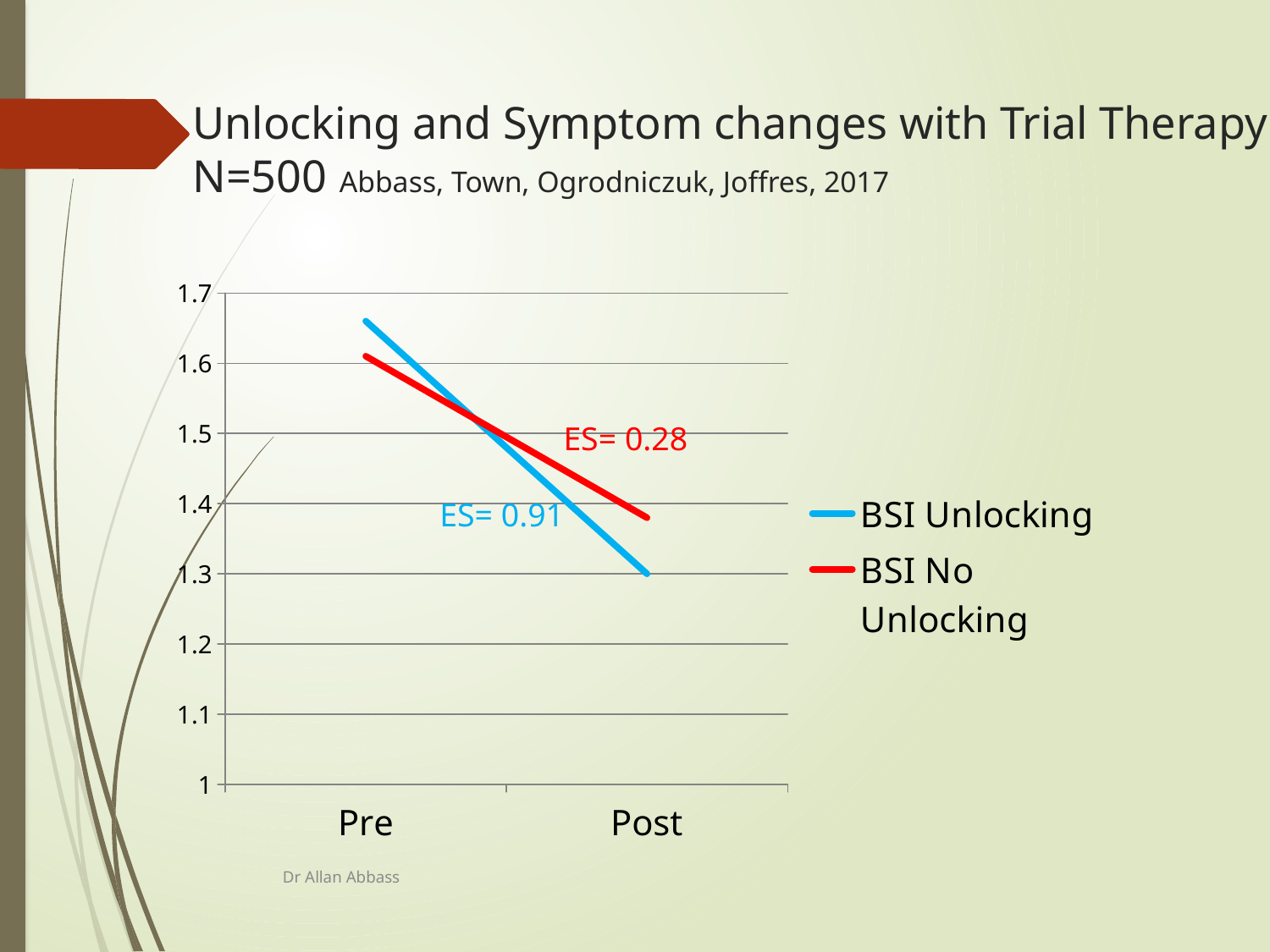
Is the Post value for BSI Unlocking greater or less than 1.4? less Is the Pre value for BSI No Unlocking greater or less than 1.5? greater Is the Pre value for BSI Unlocking greater or less than 1.6? greater What colour is the BSI No Unlocking line? red What kind of chart is shown on the slide? line chart How many time points are shown on the x axis? 2 Does the BSI Unlocking line rise or fall from Pre to Post? fall What effect size (ES) is labelled for the BSI Unlocking line? ES= 0.91 Does the BSI No Unlocking line rise or fall from Pre to Post? fall At Post, which series has the higher value, BSI Unlocking or BSI No Unlocking? BSI No Unlocking How many series does the legend list? 2